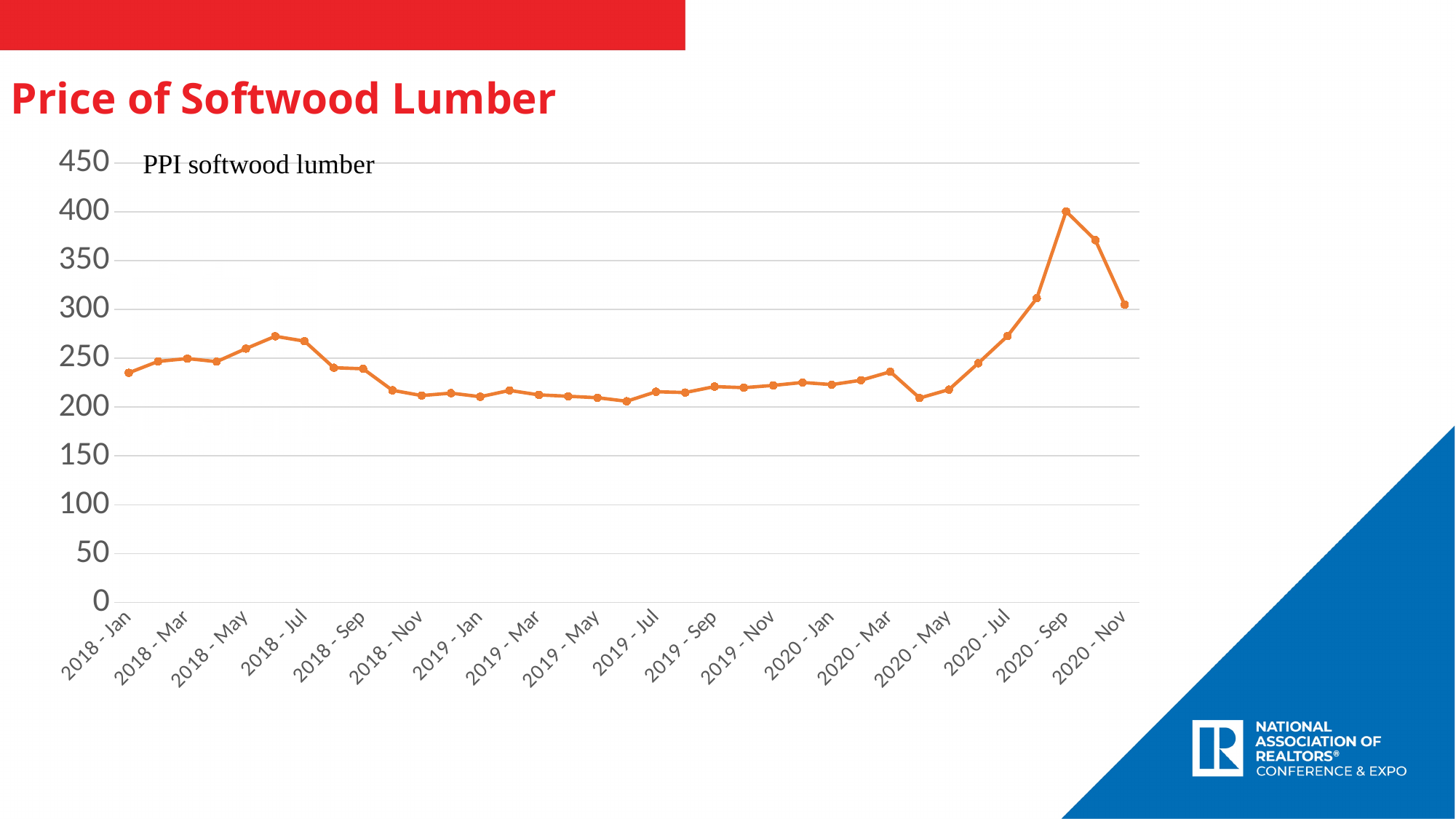
Does the line rise or fall between 2020 - May and 2020 - Sep? rise Which is higher, the value for 2020 - Sep or the value for 2018 - Jul? 2020 - Sep Is the value for 2020 - Jul greater or less than 250? greater What is the title of the slide's chart? Price of Softwood Lumber At which month does the PPI softwood lumber line reach its highest value? 2020 - Sep Is the value for 2019 - Jan greater or less than 250? less How many series does the chart plot? 1 Is the value for 2020 - Sep greater or less than 350? greater Which is higher, the value for 2020 - Nov or the value for 2018 - Jan? 2020 - Nov What kind of chart is shown on the slide? line chart